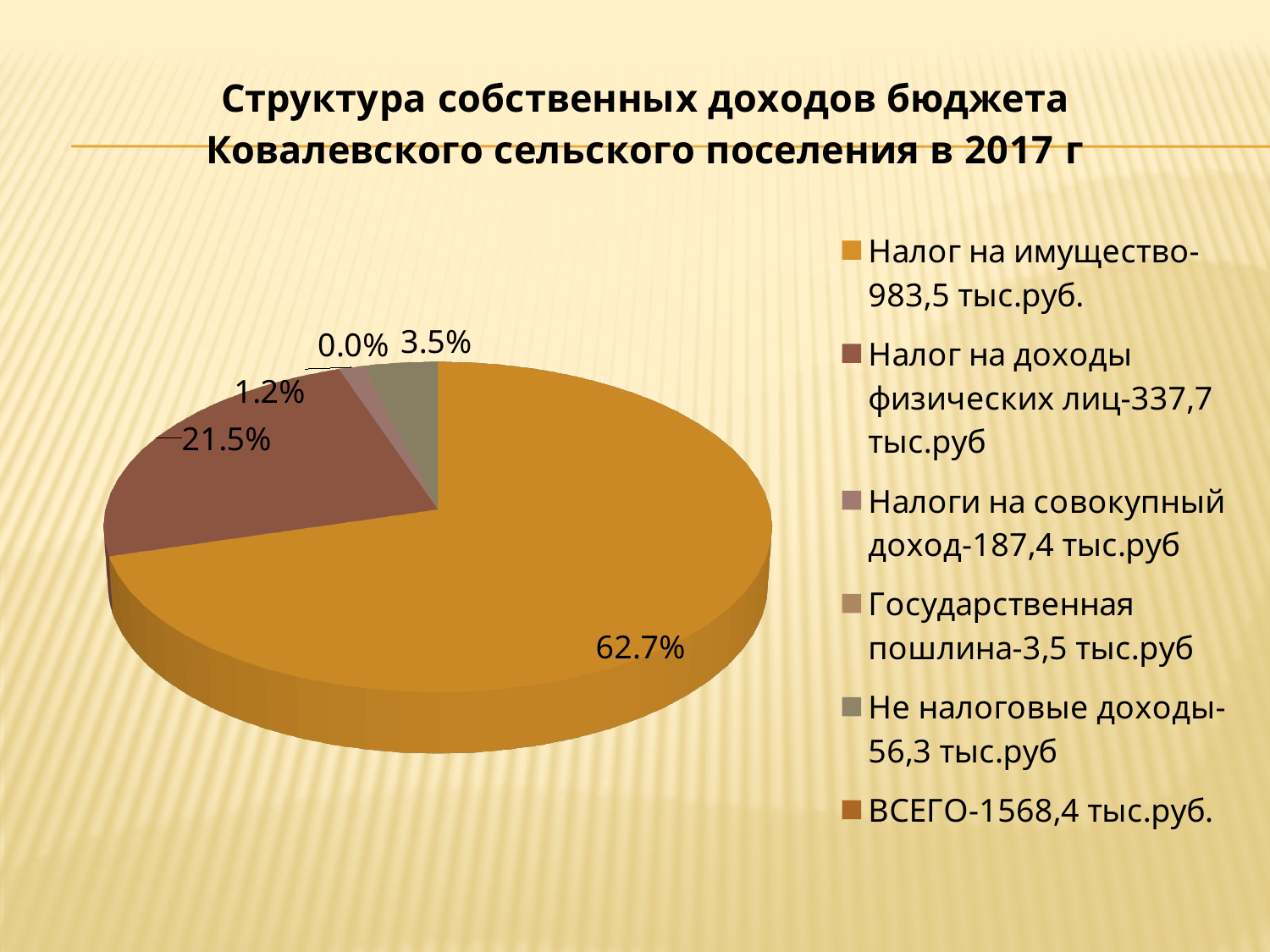
According to the legend, what is the total (ВСЕГО) amount of own budget revenues? 1568,4 тыс.руб. What year does the chart title refer to? 2017 Which slice is larger: Налог на доходы физических лиц or Не налоговые доходы? Налог на доходы физических лиц What percentage share is shown for the largest slice of the pie? 62.7% How many entries does the legend list? 6 What is the difference in percentage points between the 62.7% slice and the 21.5% slice? 41.2 What percentage is labelled on the brown slice for Налог на доходы физических лиц? 21.5% Which legend category corresponds to the largest slice of the pie? Налог на имущество-983,5 тыс.руб. What kind of chart is shown on the slide? Pie chart What percentage is labelled on the slice for Не налоговые доходы? 3.5%